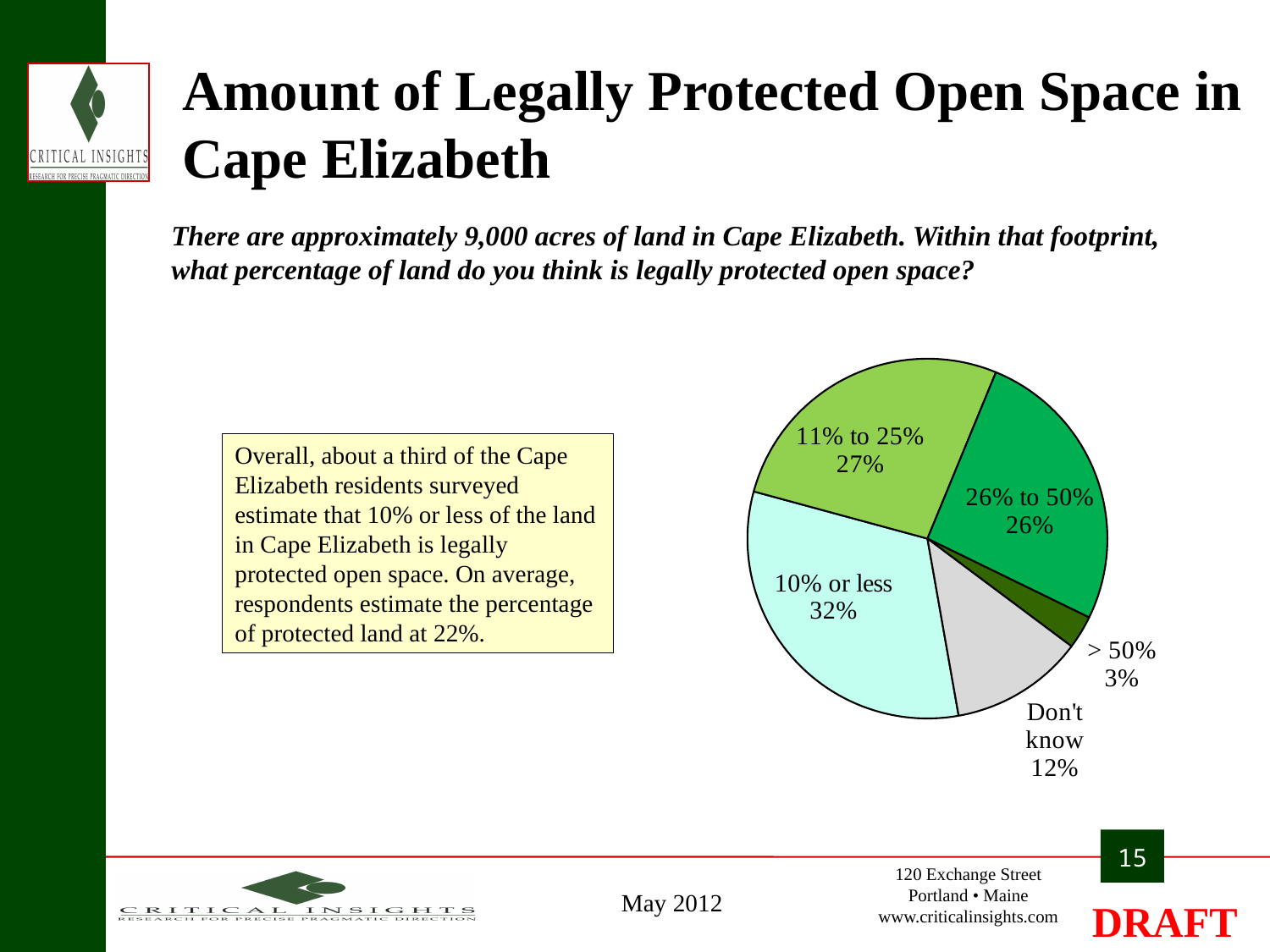
Which is larger, the '11% to 25%' slice or the '> 50%' slice? 11% to 25% What kind of chart is shown on the slide? pie chart What percentage of respondents estimated that 10% or less of the land is legally protected open space? 32% What percentage of respondents answered '26% to 50%'? 26% What percentage of respondents answered '> 50%'? 3% Which response category has the smallest slice of the pie? > 50% How many slices does the pie chart have? 5 What is the combined percentage of the '10% or less' and '11% to 25%' slices? 59% What is the difference in percentage points between the '10% or less' slice and the 'Don't know' slice? 20 Which response category has the largest slice of the pie? 10% or less What percentage of respondents answered 'Don't know'? 12% What share of the pie is labelled '11% to 25%'? 27%